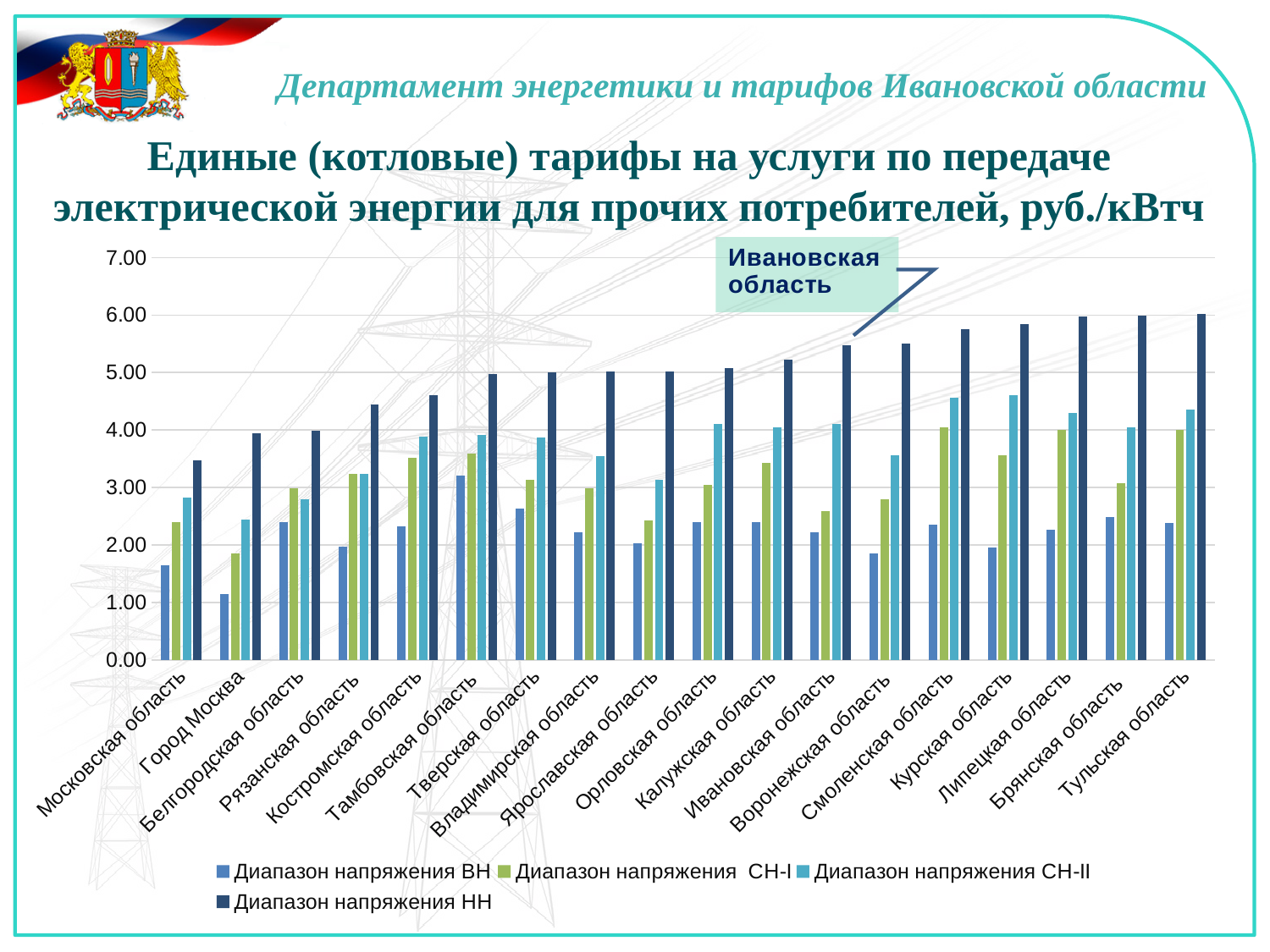
Is the value of Диапазон напряжения НН for Московская область greater or less than 4.00? less Which region is highlighted by the callout box on the chart? Ивановская область Do the values of Диапазон напряжения НН generally rise or fall from left to right along the x axis? rise How many series does the chart legend list? 4 Which region has the lowest value for Диапазон напряжения НН? Московская область Which region has the lowest value for Диапазон напряжения ВН? Город Москва How many regions (categories) are shown along the x axis of the chart? 18 Which is larger: Диапазон напряжения НН for Ивановская область or for Московская область? Ивановская область What kind of chart is shown on the slide? bar chart Is the value of Диапазон напряжения СН-II for Тульская область greater or less than 4.00? greater Is the value of Диапазон напряжения ВН for Город Москва greater or less than 2.00? less